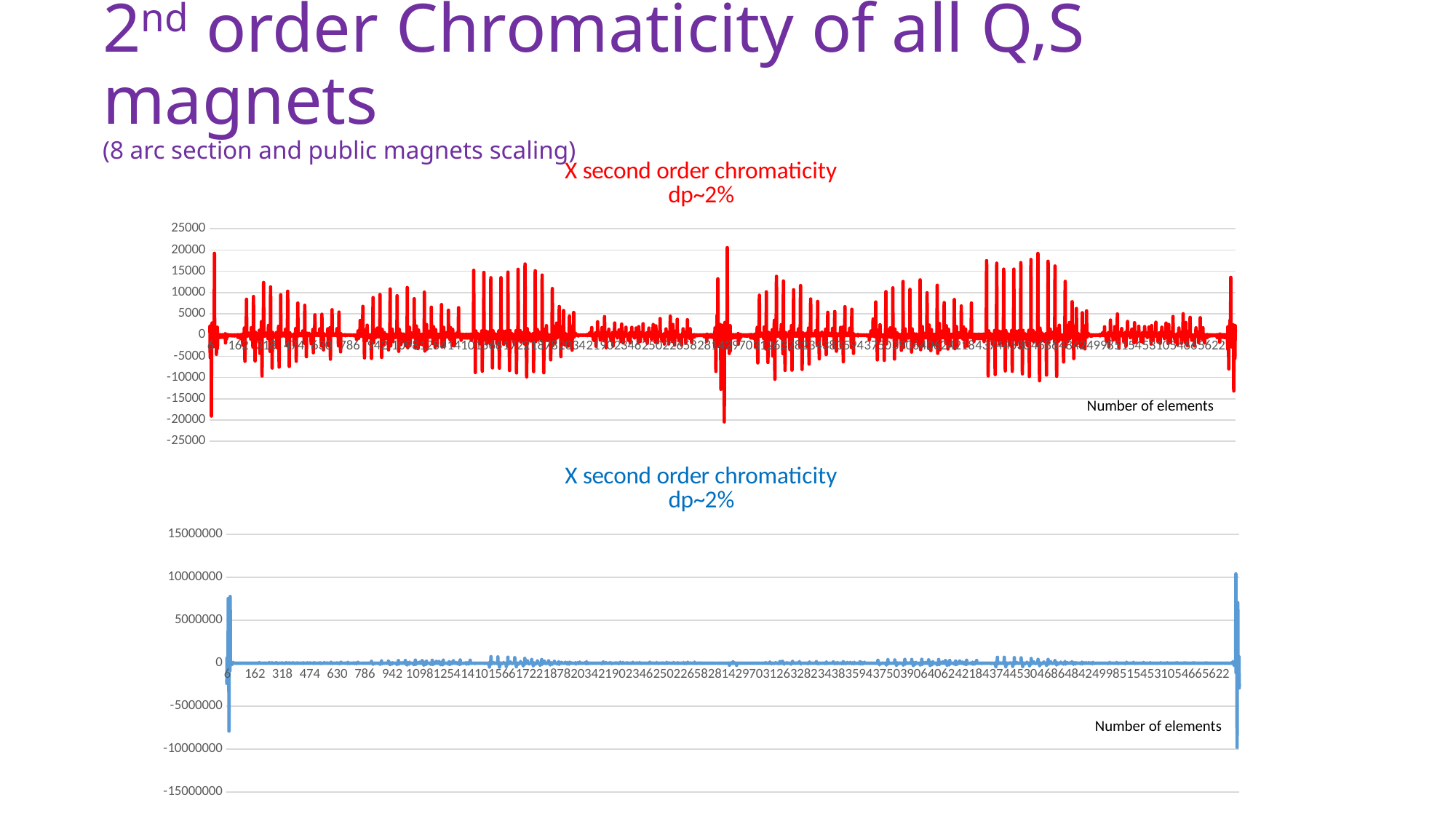
In the bottom chart, is the spike at the right edge greater or less than 15000000? less What type of chart is the bottom chart on the slide? line chart What is the title of the top (red) chart? X second order chromaticity dp~2% In the top chart, is the largest positive peak greater or less than 25000? less In the top chart, is the largest positive peak greater or less than 15000? greater What is the label shown for the x axis of the bottom chart? Number of elements What type of chart is the top chart on the slide? line chart